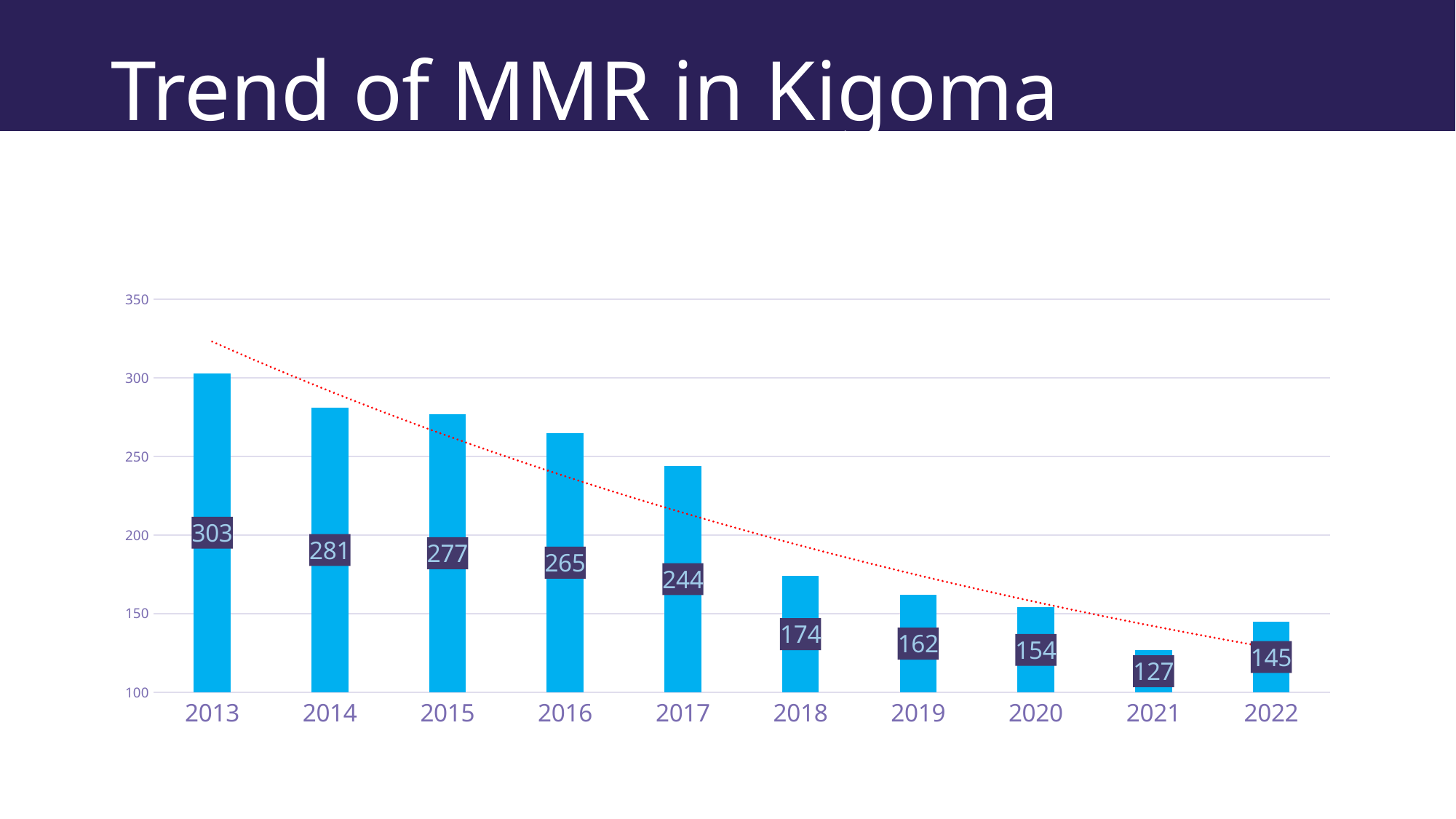
Is the value for 2016 greater or less than 250? greater What is the difference between the MMR in 2013 and the MMR in 2022? 158 What is the MMR value for 2022? 145 Which is larger, the MMR in 2020 or the MMR in 2022? 2020 How many years are shown on the x axis? 10 What is the MMR value for 2013? 303 Which year has the highest MMR? 2013 What is the difference between the MMR in 2017 and the MMR in 2018? 70 Which year has the lowest MMR? 2021 What kind of chart is shown on the slide? bar chart Do the MMR values generally rise or fall from 2013 to 2022? fall What is the MMR value for 2018? 174